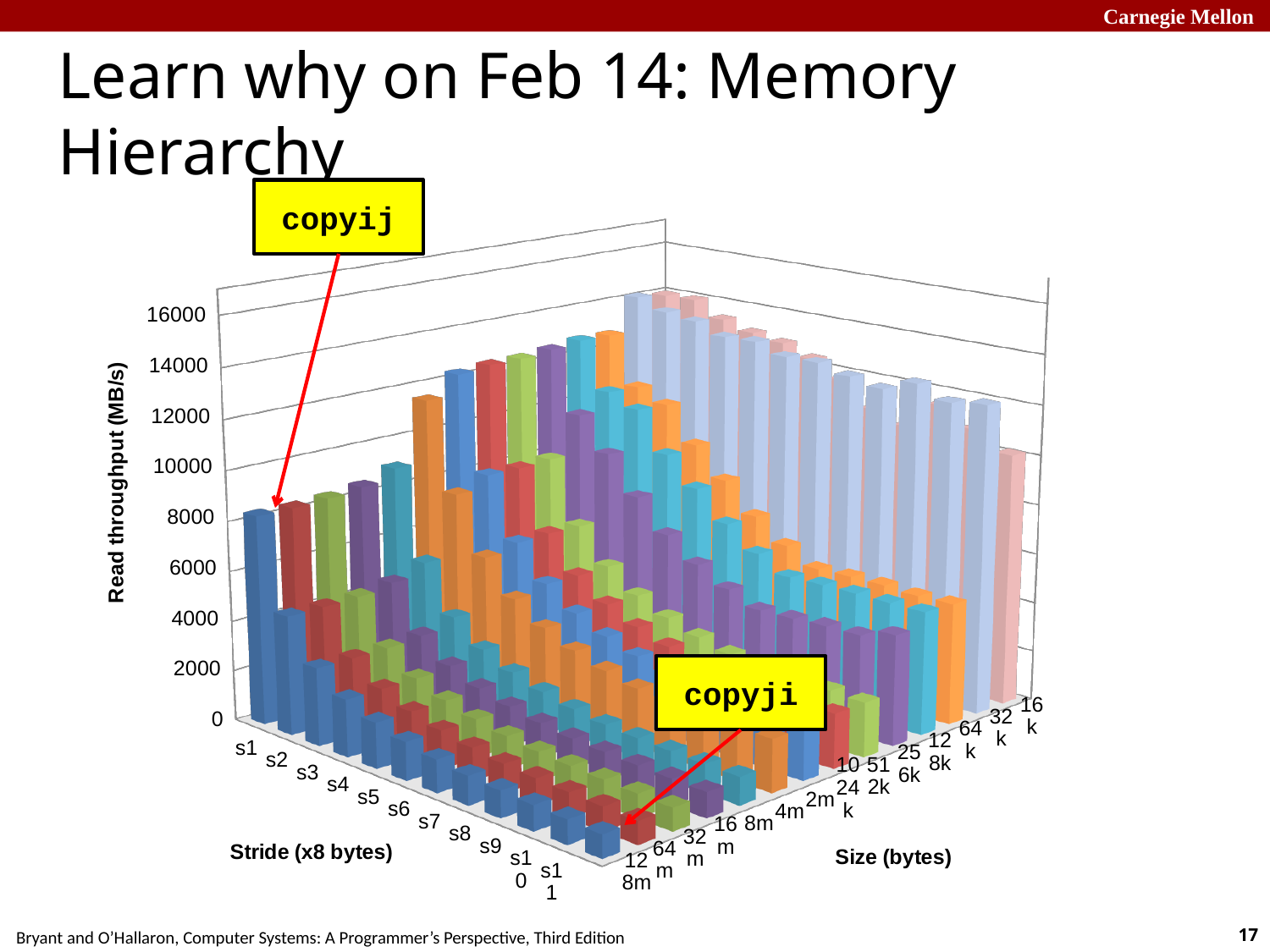
Is the read throughput for the bar labelled copyij greater or less than 4000? greater For the 128m size, does read throughput rise or fall as stride increases from s1 to s11? fall What kind of chart is shown on the slide? 3D bar chart For the 128m size, which stride has the highest read throughput? s1 For the 128m size, which stride has the lowest read throughput? s11 Is the read throughput for the bar labelled copyji greater or less than 2000? less What is the title of the vertical axis of the chart? Read throughput (MB/s) How many stride categories (s1, s2, ...) are shown on the chart? 11 What is the label of the axis showing s1 through s11? Stride (x8 bytes) How many size categories are shown on the Size (bytes) axis? 14 What is the highest tick value shown on the Read throughput axis? 16000 Which is larger: the read throughput for copyij or for copyji? copyij